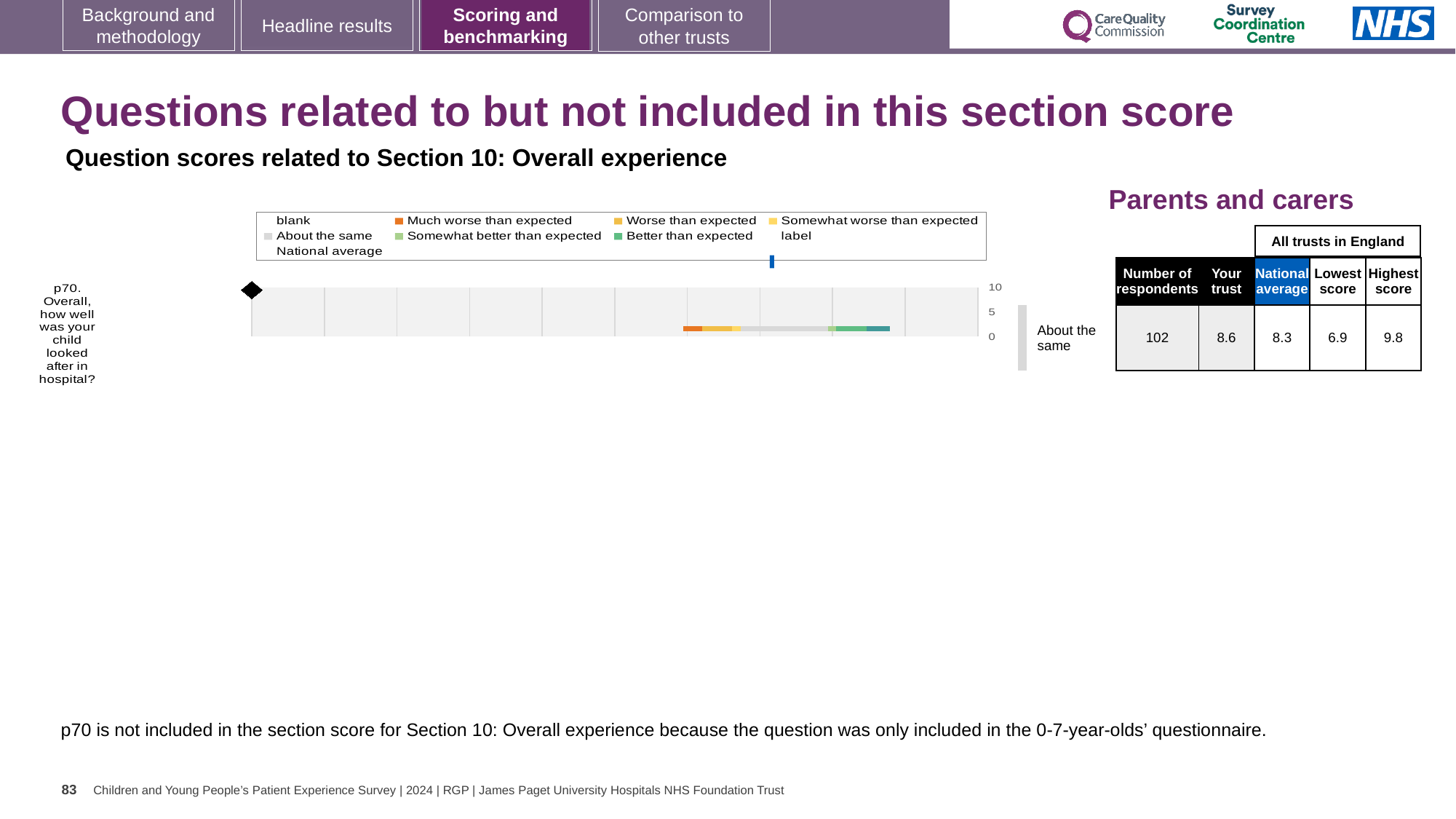
What is the national average score for p70? 8.3 How many questions are plotted in the chart? 1 How many respondents answered p70? 102 Which respondent group does the chart and table relate to? Parents and carers What is the difference between the highest and lowest scores for p70 across all trusts in England? 2.9 What is the highest score among all trusts in England for p70? 9.8 What kind of chart is used to show the p70 question score? bar chart What is the lowest score among all trusts in England for p70? 6.9 What is the 'Your trust' score for p70? 8.6 What benchmark category is shown for p70 (Overall, how well was your child looked after in hospital?)? About the same What is the difference between the 'Your trust' score and the national average for p70? 0.3 Which is larger for p70: the 'Your trust' score or the national average? Your trust